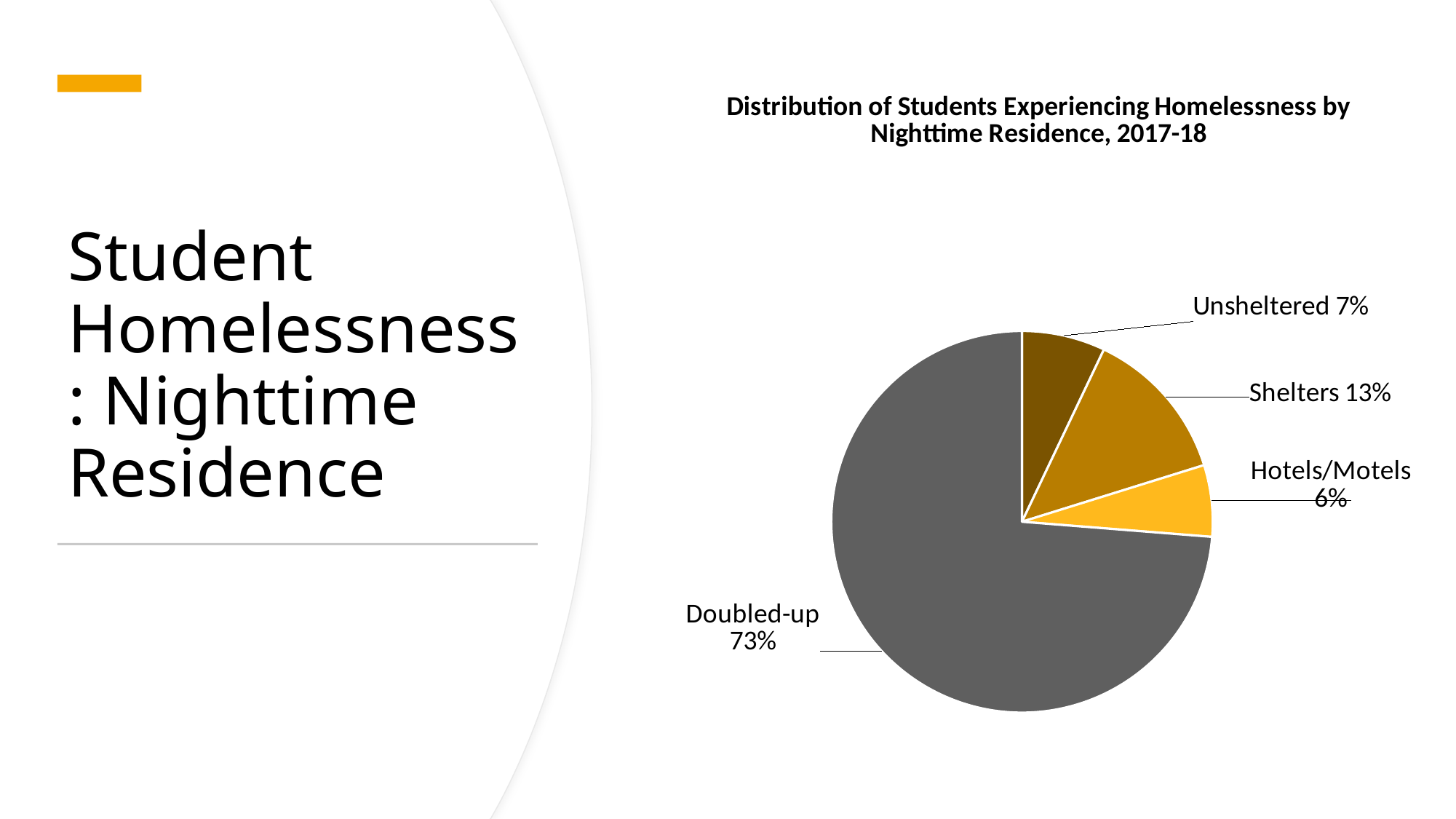
What percentage of students experiencing homelessness stayed in Hotels/Motels? 6% How many nighttime residence categories are shown in the pie chart? 4 What percentage of students experiencing homelessness stayed in Shelters? 13% What share of students experiencing homelessness were Doubled-up in 2017-18? 73% Which nighttime residence category has the largest share of the pie? Doubled-up What is the difference in percentage points between the Doubled-up share and the Shelters share? 60 What percentage of students experiencing homelessness were Unsheltered? 7% Which nighttime residence category has the smallest share of the pie? Hotels/Motels What type of chart is shown on the slide? Pie chart What is the difference in percentage points between the Shelters share and the Unsheltered share? 6 What is the title of the chart? Distribution of Students Experiencing Homelessness by Nighttime Residence, 2017-18 Which is larger, the share for Shelters or the share for Hotels/Motels? Shelters